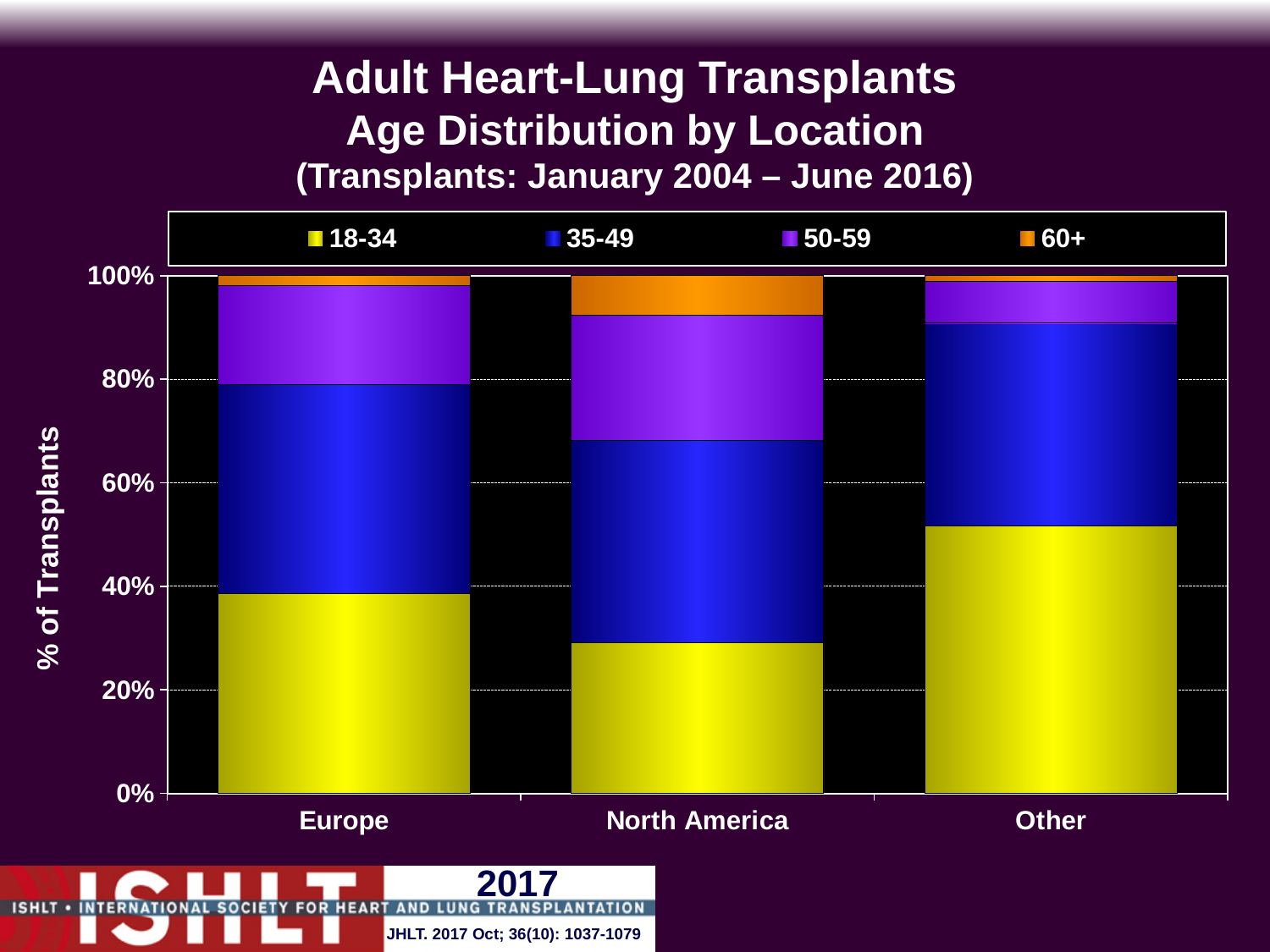
Which colour represents the 18-34 age group in the legend? Yellow What kind of chart is shown on the slide? Stacked bar chart Is the share of 18-34 transplants for Other greater or less than 40%? greater How many age groups does the legend list? 4 Which location has the smallest share of transplants in the 50-59 age group? Other Which location has the smallest share of transplants in the 18-34 age group? North America Is the share of 18-34 transplants for Europe greater or less than 40%? less Which location has the largest share of transplants in the 18-34 age group? Other Is the share of 18-34 transplants for North America greater or less than 20%? greater How many locations are shown on the x axis of the chart? 3 Which location has a larger 50-59 segment, Europe or North America? North America Which location has the largest share of transplants in the 60+ age group? North America